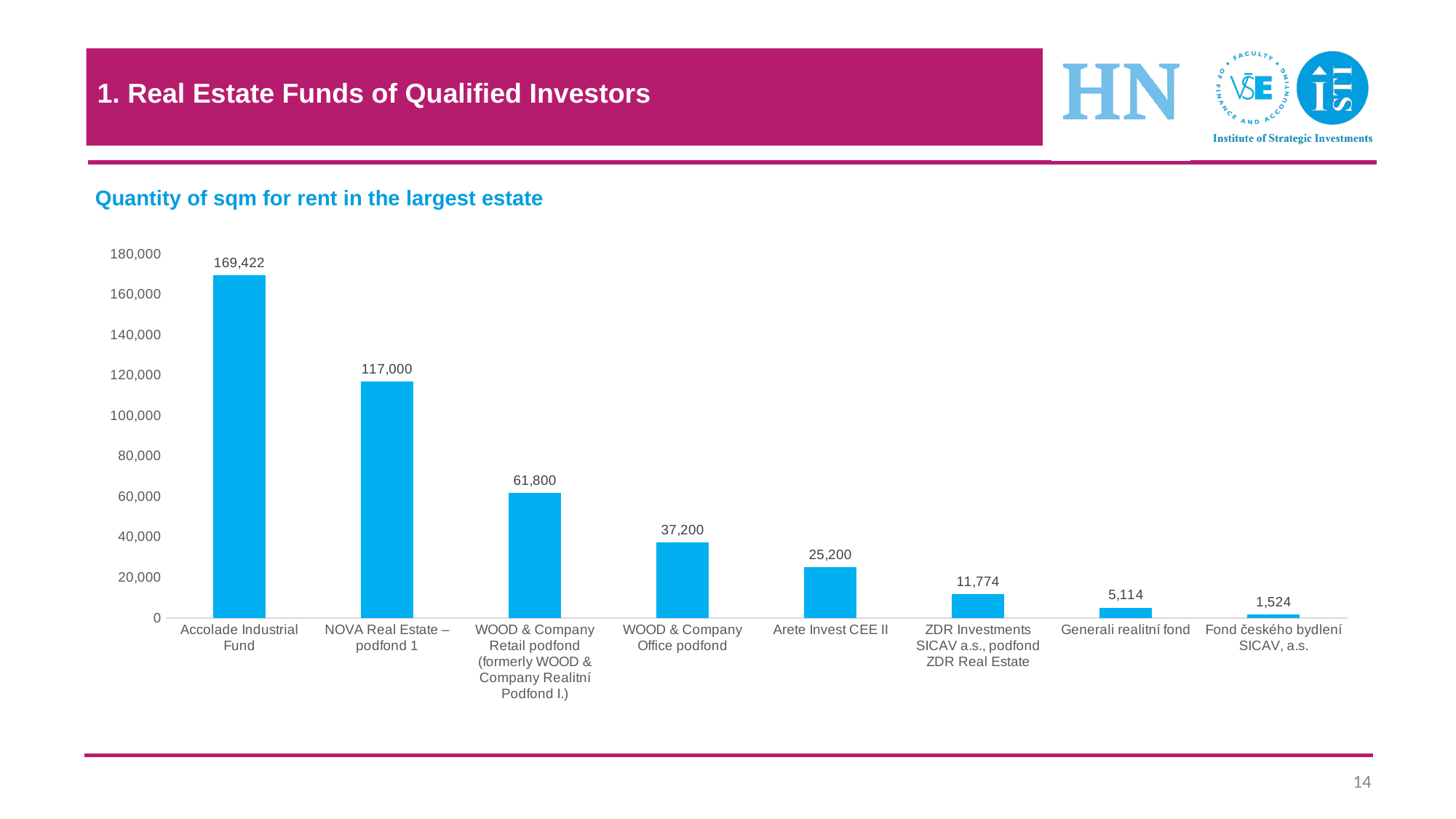
What is the quantity of sqm for rent in the largest estate for Accolade Industrial Fund? 169,422 What value is shown for WOOD & Company Office podfond? 37,200 What kind of chart is shown on the slide? Bar chart What value is shown for Generali realitní fond? 5,114 How many funds are shown in the chart? 8 Is the value for WOOD & Company Retail podfond (formerly WOOD & Company Realitní Podfond I.) greater or less than 60,000? greater What value is shown for NOVA Real Estate – podfond 1? 117,000 Which fund has the lowest quantity of sqm for rent in the largest estate? Fond českého bydlení SICAV, a.s. Which fund has the highest quantity of sqm for rent in the largest estate? Accolade Industrial Fund Which is larger: the value for Arete Invest CEE II or the value for ZDR Investments SICAV a.s., podfond ZDR Real Estate? Arete Invest CEE II What is the title of the chart? Quantity of sqm for rent in the largest estate What is the difference between the values for Accolade Industrial Fund and NOVA Real Estate – podfond 1? 52,422